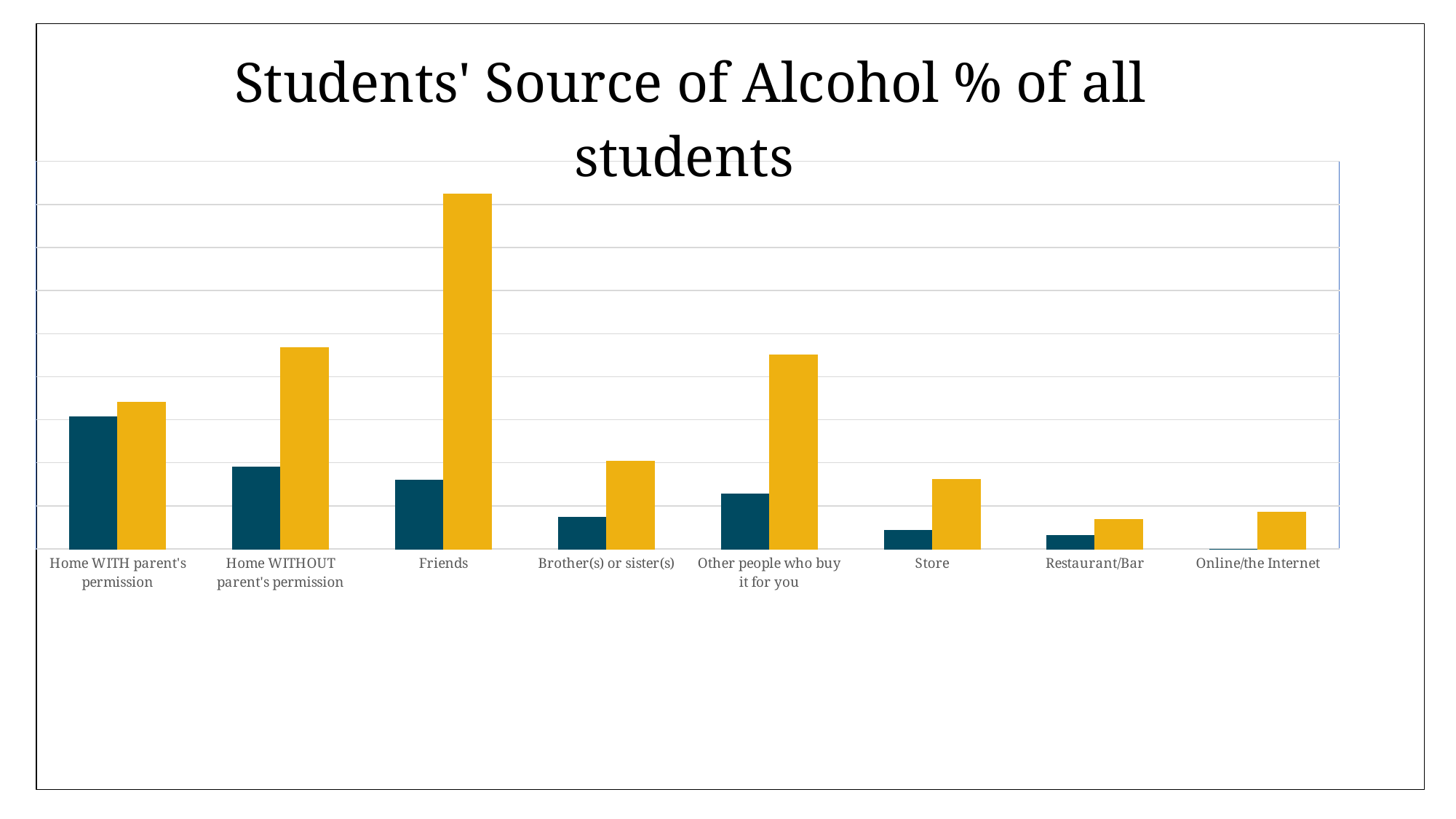
Is the dark blue bar taller for Home WITH parent's permission or for Home WITHOUT parent's permission? Home WITH parent's permission How many source categories are shown along the x axis? 8 Is the yellow bar taller for Friends or for Other people who buy it for you? Friends What is the title of the chart? Students' Source of Alcohol % of all students Which category has the tallest dark blue bar? Home WITH parent's permission How many bars are plotted for each category? 2 What kind of chart is shown on the slide? Bar chart Is the yellow bar taller for Brother(s) or sister(s) or for Store? Brother(s) or sister(s) Which category has the shortest dark blue bar? Online/the Internet Which category has the tallest yellow bar? Friends In every category, which bar is taller, the dark blue one or the yellow one? The yellow one